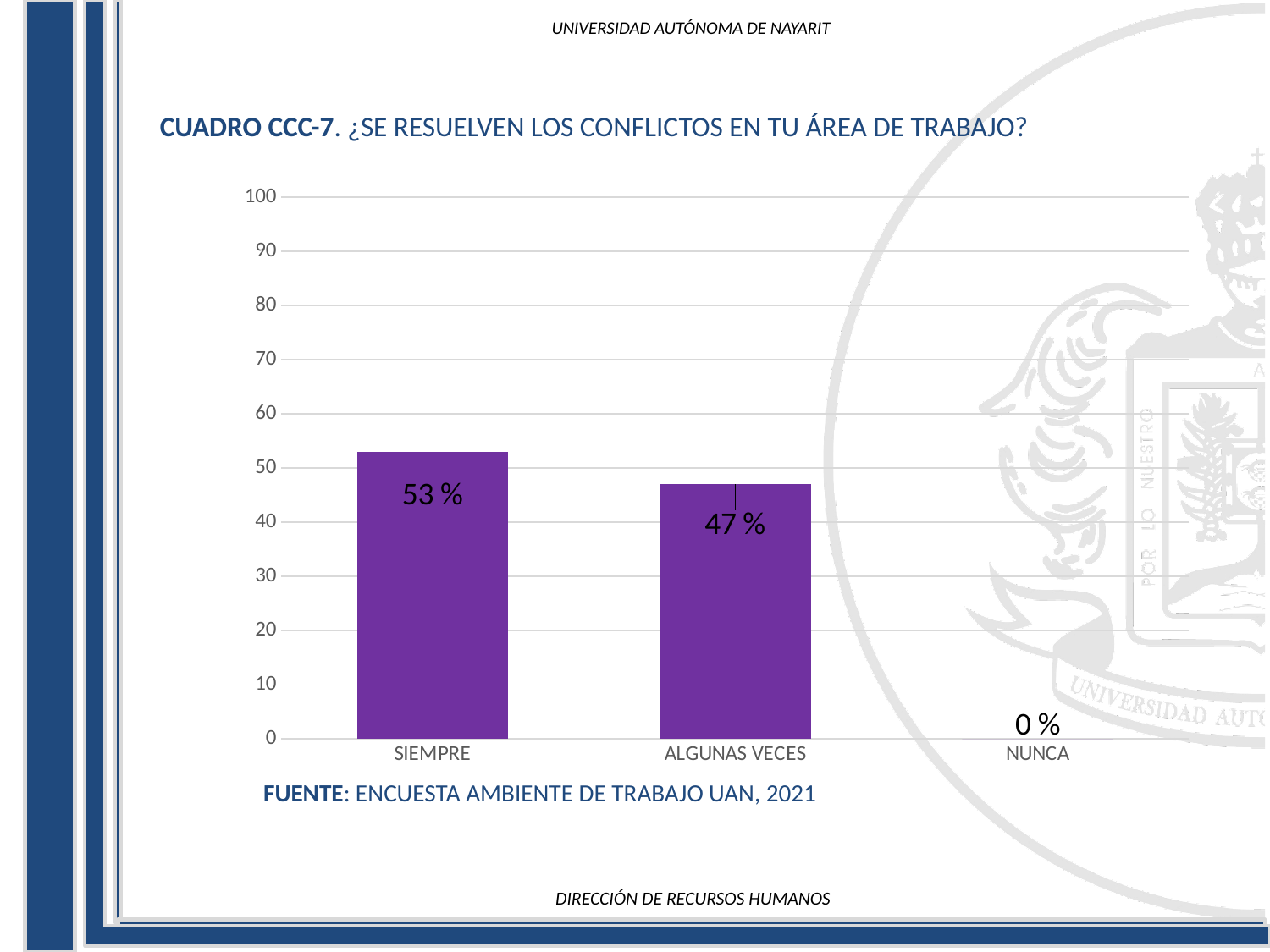
What is the source cited below the chart? ENCUESTA AMBIENTE DE TRABAJO UAN, 2021 What is the value for ALGUNAS VECES? 47 % How many categories are shown on the x axis? 3 What is the value for NUNCA? 0 % Which is larger, the value for SIEMPRE or the value for ALGUNAS VECES? SIEMPRE What is the difference between the values for SIEMPRE and ALGUNAS VECES? 6 % What is the value for SIEMPRE? 53 % What kind of chart is shown on the slide? bar chart Which category has the lowest value? NUNCA Is the value for SIEMPRE greater or less than 50? greater Is the value for ALGUNAS VECES greater or less than 50? less Which category has the highest value? SIEMPRE